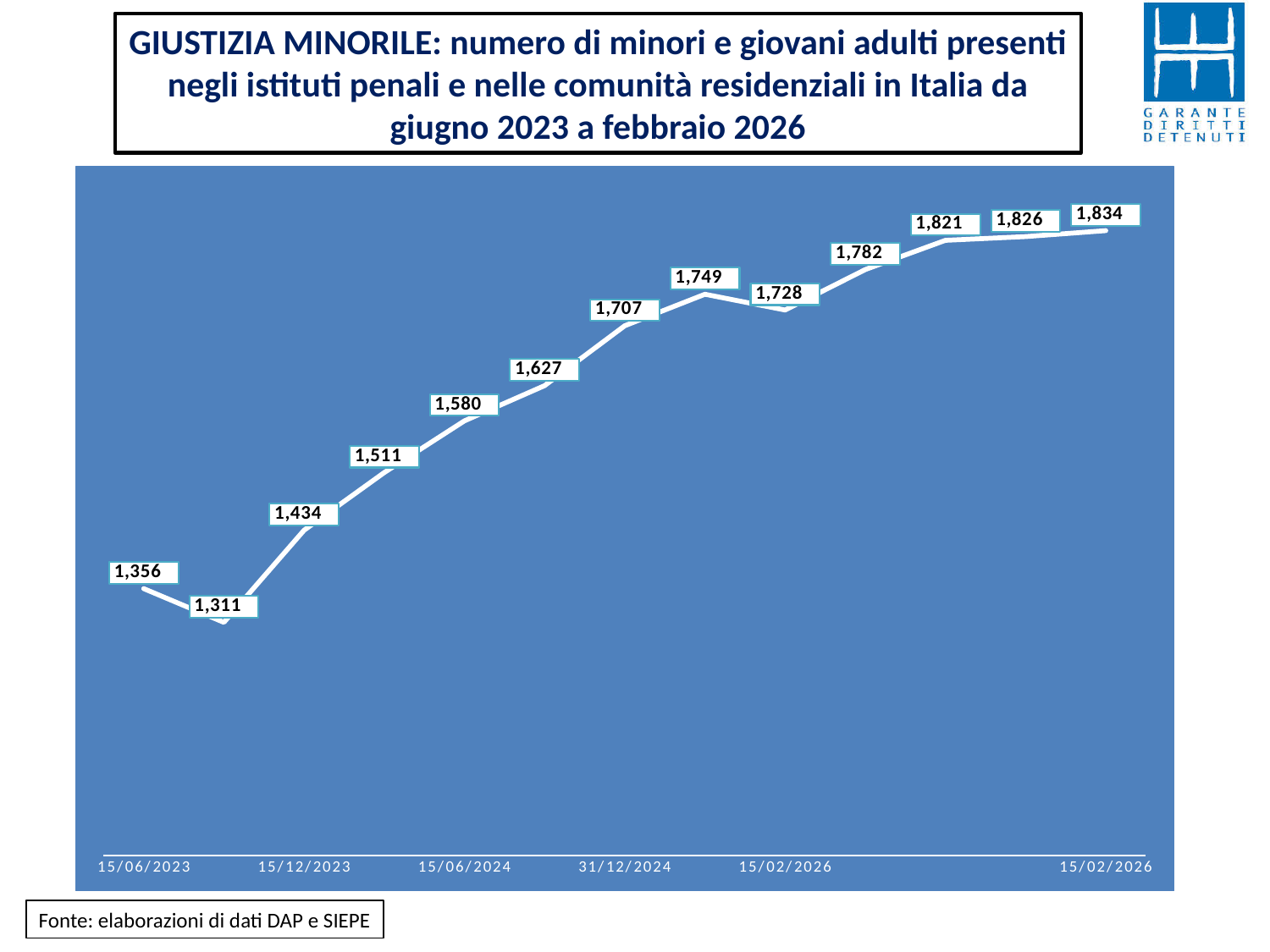
What kind of chart is shown on the slide? line chart What is the lowest value shown on the chart? 1,311 What is the difference between the data point labelled 1,749 and the following point labelled 1,728? 21 Overall, do the values rise or fall from left to right along the x axis? rise What is the value of the first data point, at 15/06/2023? 1,356 What is the highest value shown on the chart? 1,834 How many data points are plotted on the line? 13 What is the difference between the last data point (1,834) and the first data point (1,356)? 478 What is the difference between the second data point (1,311) and the third data point (1,434)? 123 Which is larger: the data point labelled 1,749 or the one immediately after it? 1,749 What is the value of the last data point on the chart? 1,834 What source is cited below the chart? Fonte: elaborazioni di dati DAP e SIEPE